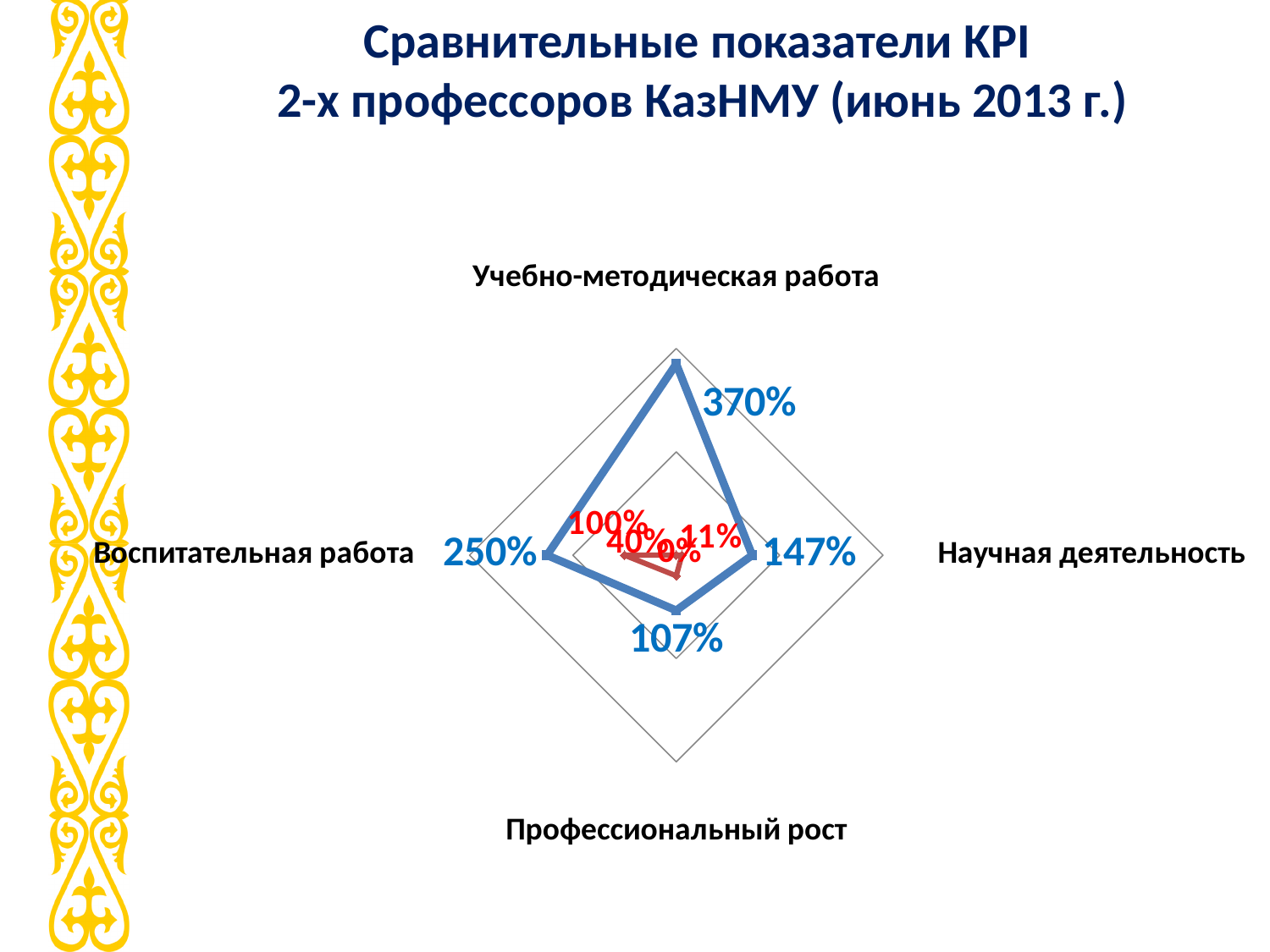
What is the value of the blue series for Воспитательная работа? 250% For the blue series, which is larger: Научная деятельность or Профессиональный рост? Научная деятельность What is the title of the chart on the slide? Сравнительные показатели KPI 2-х профессоров КазНМУ (июнь 2013 г.) What type of chart is shown on the slide? Radar chart What is the value of the blue series for Научная деятельность? 147% How many categories (axes) does the radar chart have? 4 How many data series are plotted on the radar chart? 2 What is the value of the blue series for Профессиональный рост? 107% What is the difference between the blue series values for Учебно-методическая работа and Воспитательная работа? 120% In which category does the blue series have its highest value? Учебно-методическая работа What is the value of the blue series for Учебно-методическая работа? 370% In which category does the blue series have its lowest value? Профессиональный рост